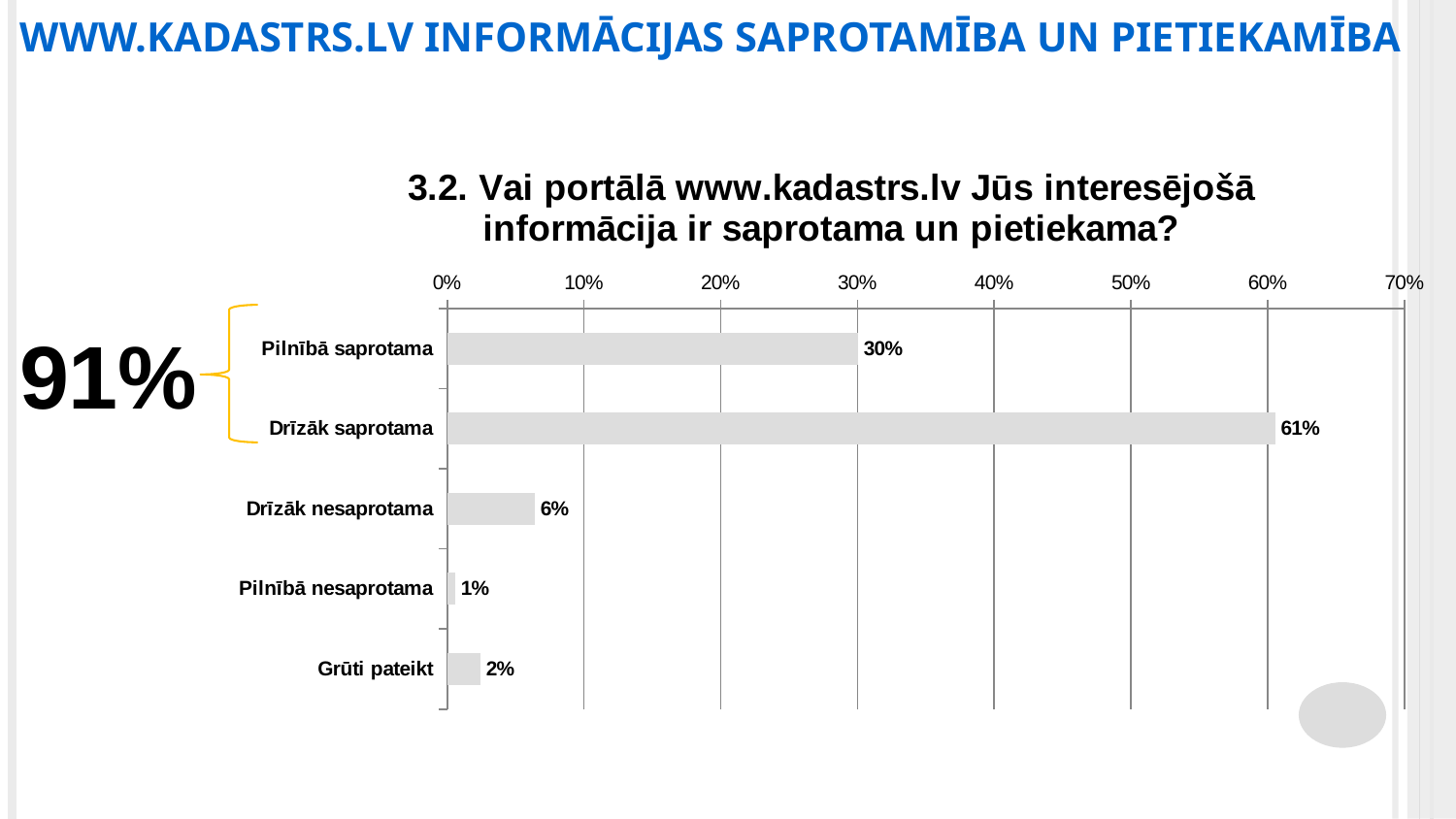
What is the value for "Drīzāk saprotama"? 61% What is the value for "Grūti pateikt"? 2% What is the value for "Pilnībā saprotama"? 30% Which category has the lowest value? Pilnībā nesaprotama Which category has the highest value? Drīzāk saprotama What kind of chart is shown on the slide? bar chart What is the difference between the values for "Drīzāk saprotama" and "Pilnībā saprotama"? 31% How many categories are shown in the chart? 5 Is the value for "Drīzāk saprotama" greater or less than 50%? greater What is the combined total of "Pilnībā saprotama" and "Drīzāk saprotama"? 91% What is the value for "Drīzāk nesaprotama"? 6% Which is larger, the value for "Drīzāk nesaprotama" or the value for "Grūti pateikt"? Drīzāk nesaprotama